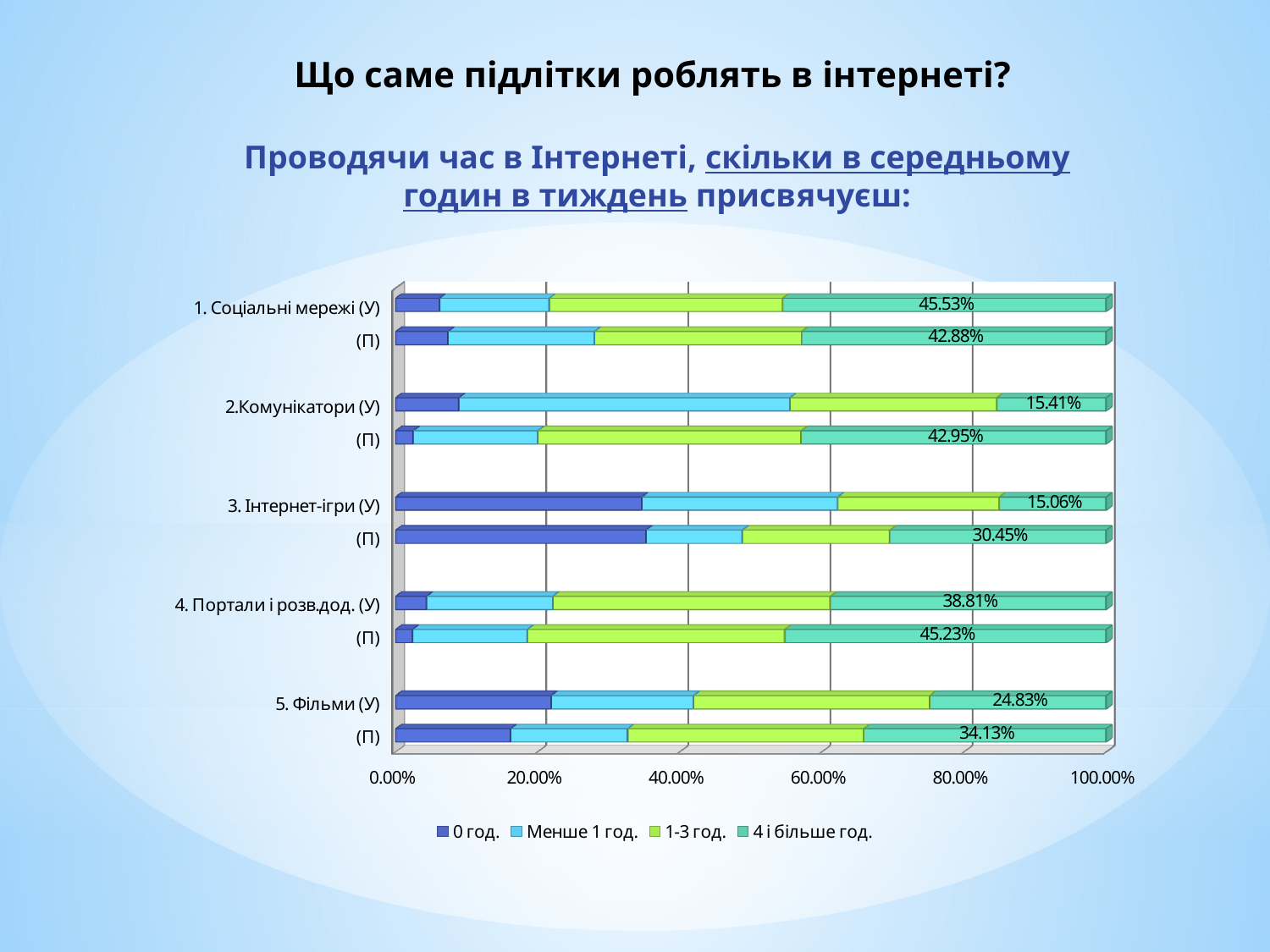
Which has a larger '4 і більше год.' value: '4. Портали і розв.дод. (П)' or '4. Портали і розв.дод. (У)'? 4. Портали і розв.дод. (П) What is the value of the '4 і більше год.' segment for '5. Фільми (У)'? 24.83% What is the value of the '4 і більше год.' segment for '2.Комунікатори (П)'? 42.95% What is the value of the '4 і більше год.' segment for '1. Соціальні мережі (У)'? 45.53% Which bar has the lowest labelled '4 і більше год.' value? 3. Інтернет-ігри (У) Is the '0 год.' value for '3. Інтернет-ігри (У)' greater or less than 20.00%? greater How many bars (category rows) are plotted in the chart? 10 How many series does the legend list? 4 Which legend entry is shown in dark blue? 0 год. What kind of chart is shown on the slide? stacked bar chart What is the difference between the '4 і більше год.' values for '3. Інтернет-ігри (П)' and '3. Інтернет-ігри (У)'? 15.39% Which bar has the highest labelled '4 і більше год.' value? 1. Соціальні мережі (У)